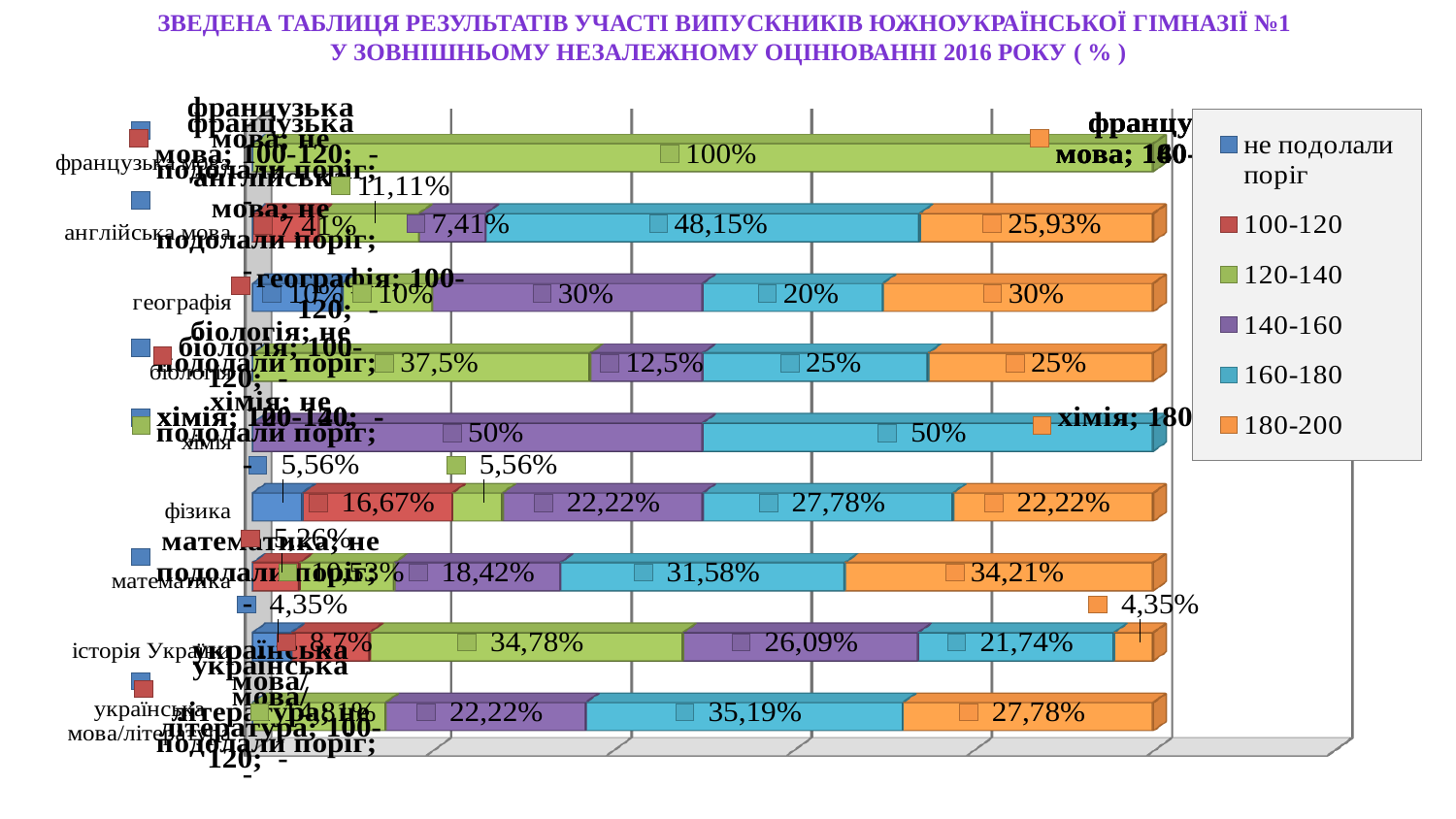
What is the value of the 120-140 series for французька мова? 100% What is the difference between the 160-180 value and the 180-200 value for математика? 2,63% What is the value of the 120-140 series for історія України? 34,78% Which legend entry is shown in orange? 180-200 What is the value of the 180-200 series for математика? 34,21% How many series does the legend list? 6 What kind of chart is shown on the slide? Stacked bar chart What is the value of the 160-180 series for англійська мова? 48,15% Which is larger for фізика: the 160-180 value or the 180-200 value? 160-180 What is the value of the 160-180 series for українська мова/література? 35,19% How many subject categories are plotted on the chart? 9 What is the value of the 140-160 series for географія? 30%